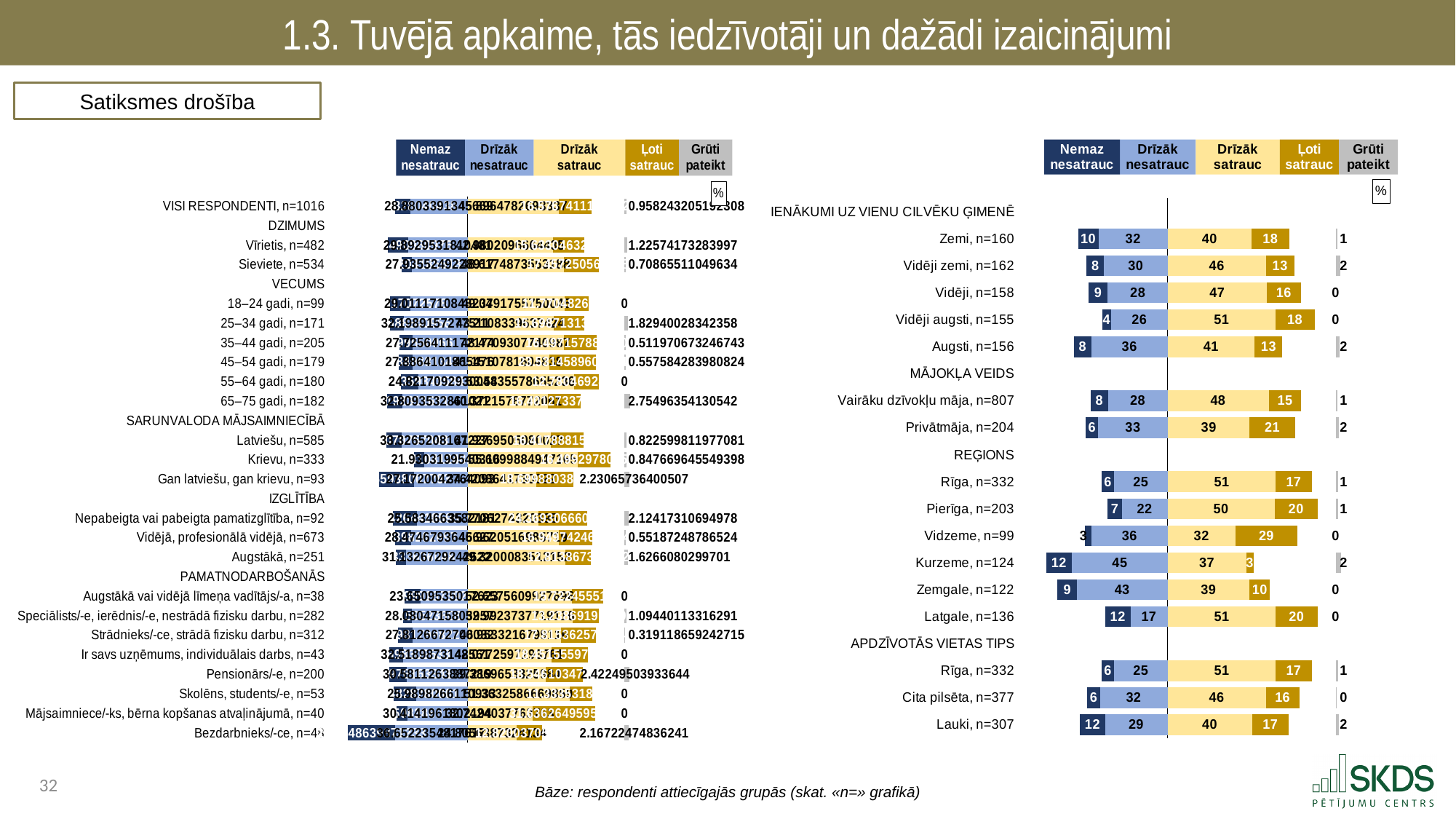
How many series does the legend of the right-hand chart list? 5 In the right-hand chart, which has a larger "Drīzāk satrauc" value: Zemi, n=160 or Vidēji zemi, n=162? Vidēji zemi, n=162 How many category rows with bars are plotted in the right-hand chart? 16 In the right-hand chart, what is the "Nemaz nesatrauc" value for Kurzeme, n=124? 12 In the right-hand chart, what is the "Ļoti satrauc" value for Privātmāja, n=204? 21 In the right-hand chart, which legend entry is shown in dark gold? Ļoti satrauc What kind of chart is the right-hand chart? Stacked horizontal bar chart In the right-hand chart, what is the difference between the "Drīzāk nesatrauc" values for Kurzeme, n=124 and Latgale, n=136? 28 In the right-hand chart, what is the "Drīzāk satrauc" value for Vidēji augsti, n=155? 51 In the right-hand chart, what is the total of all segments for Kurzeme, n=124? 99 In the right-hand chart, which region under REĢIONS has the lowest "Ļoti satrauc" value? Kurzeme, n=124 In the right-hand chart, which region under REĢIONS has the highest "Ļoti satrauc" value? Vidzeme, n=99